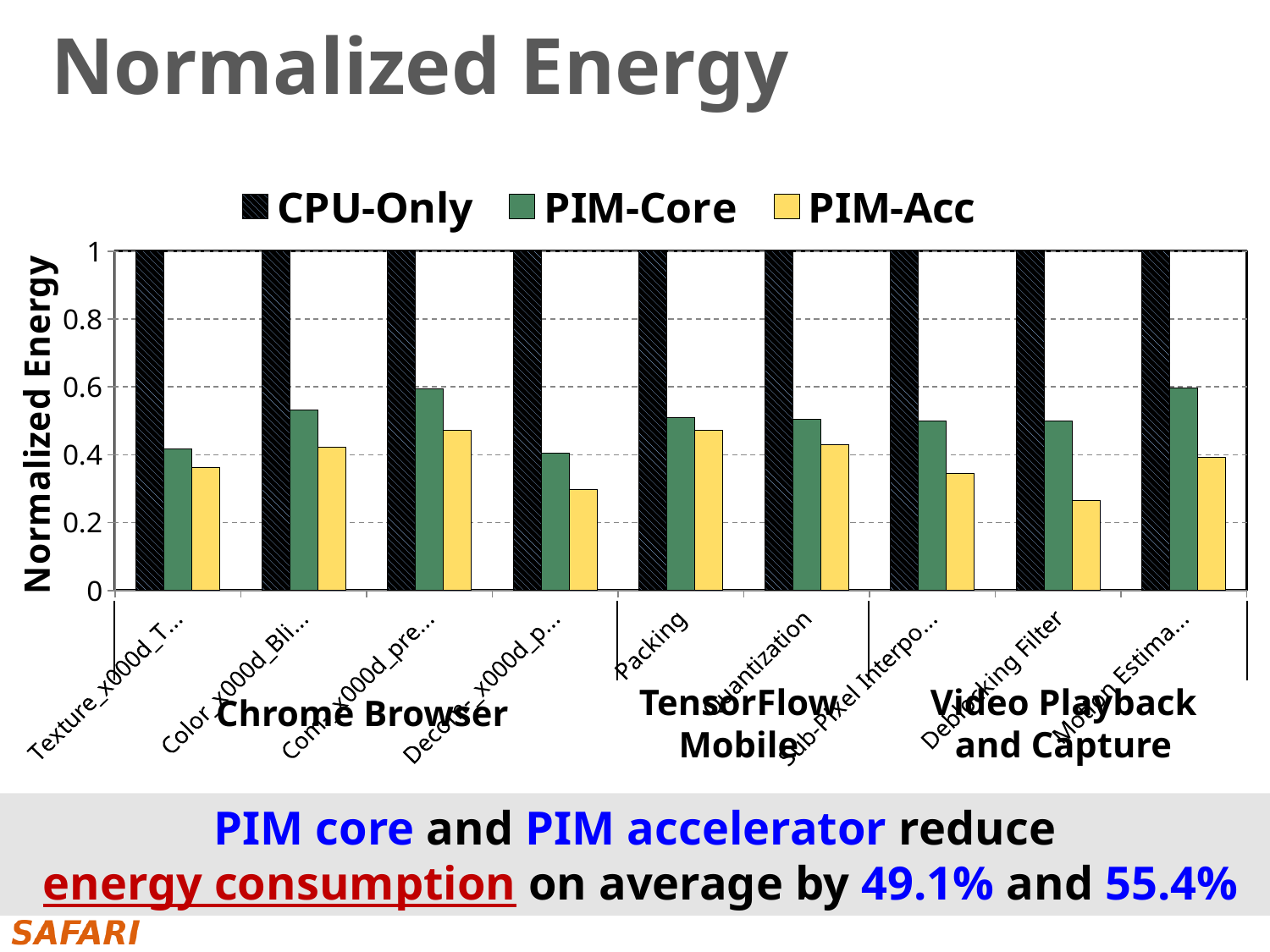
Is the PIM-Acc value for Deblocking Filter greater or less than 0.4? less How many categories (workloads) are plotted along the x axis? 9 What is the title of the y axis? Normalized Energy Is the PIM-Core value for Packing greater or less than 0.6? less How many series does the legend list? 3 For Deblocking Filter, which is larger: the PIM-Core value or the PIM-Acc value? PIM-Core Is the PIM-Core value for Deblocking Filter greater or less than 0.4? greater What kind of chart is shown on the slide? bar chart What are the three series named in the legend? CPU-Only, PIM-Core, PIM-Acc What is the normalized energy value for CPU-Only for Packing? 1 What is the normalized energy value for CPU-Only for Deblocking Filter? 1